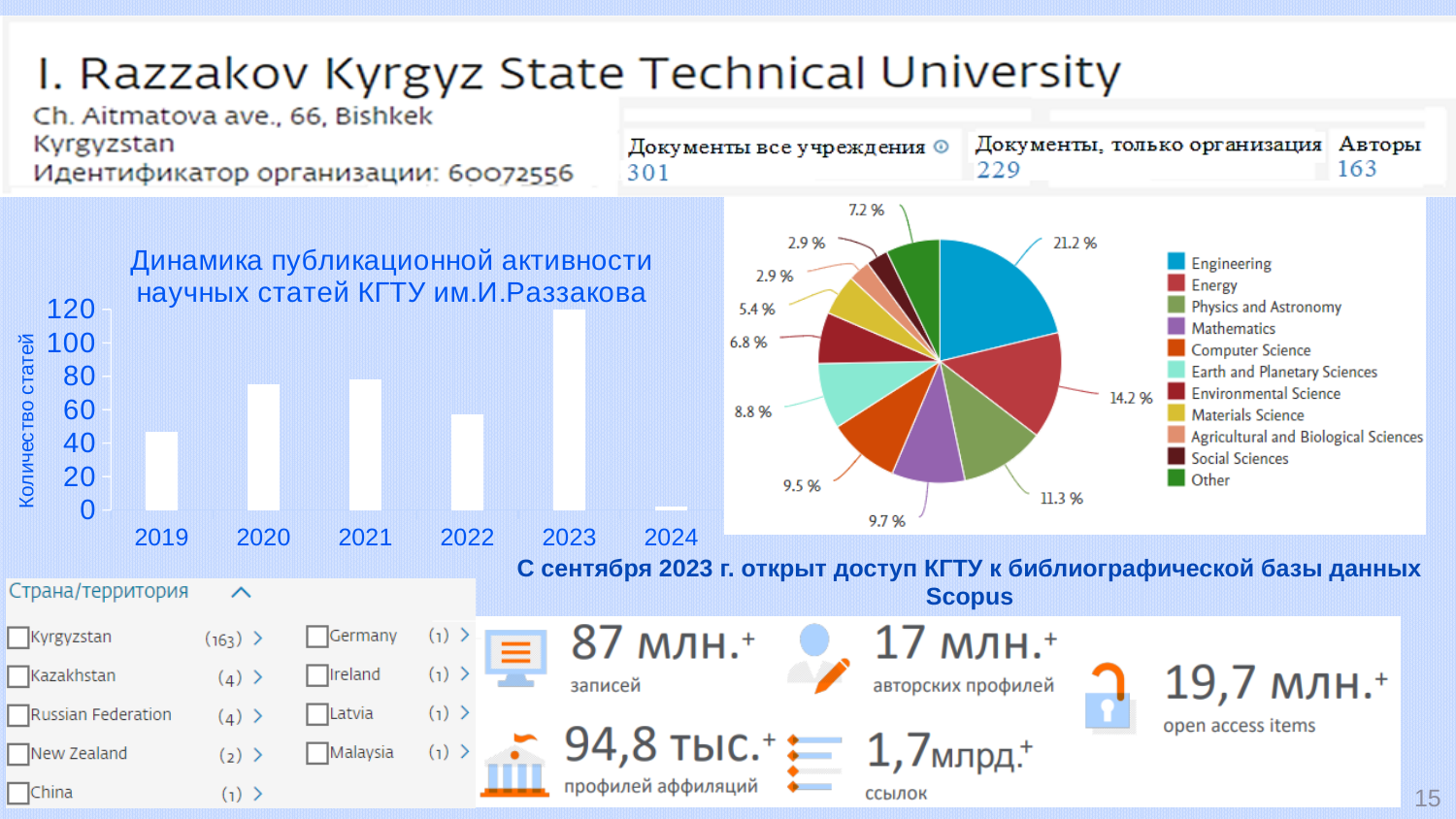
How many years are shown on the x axis of the bar chart 'Динамика публикационной активности научных статей КГТУ им.И.Раззакова'? 6 In the pie chart on the right, what share does Engineering have? 21.2 % In the pie chart on the right, which subject area has the largest share? Engineering What type of chart is 'Динамика публикационной активности научных статей КГТУ им.И.Раззакова'? bar chart In the pie chart on the right, what share does Energy have? 14.2 % In the bar chart 'Динамика публикационной активности научных статей КГТУ им.И.Раззакова', is the value for 2023 greater or less than 100? greater In the bar chart 'Динамика публикационной активности научных статей КГТУ им.И.Раззакова', is the value for 2019 greater or less than 60? less How many subject areas does the legend of the pie chart on the right list? 11 In the bar chart 'Динамика публикационной активности научных статей КГТУ им.И.Раззакова', which year has the lowest number of articles? 2024 In the pie chart on the right, what is the difference between the Engineering share and the Energy share? 7.0 % In the bar chart 'Динамика публикационной активности научных статей КГТУ им.И.Раззакова', which year has the highest number of articles? 2023 In the bar chart 'Динамика публикационной активности научных статей КГТУ им.И.Раззакова', which year has more articles, 2020 or 2022? 2020